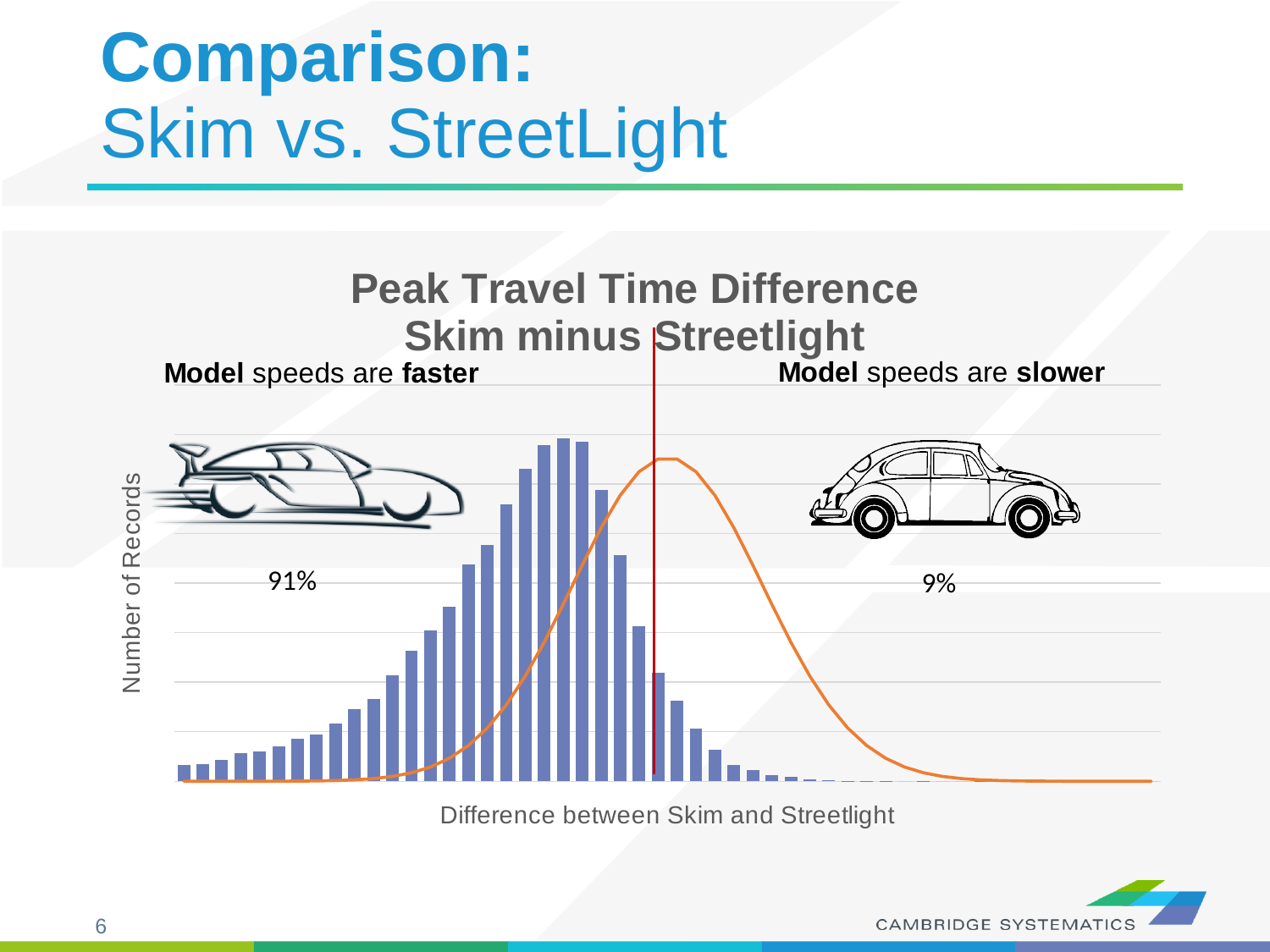
Which side of the chart has the larger share of records: where model speeds are faster or where model speeds are slower? Model speeds are faster What is the label on the vertical axis of the chart? Number of Records What is the difference between the percentage shown on the left side (91%) and the percentage shown on the right side (9%)? 82% What is the title of the chart? Peak Travel Time Difference Skim minus Streetlight What percentage is shown on the right side of the chart, where model speeds are slower? 9% Do the bar heights rise or fall moving from the left edge of the chart toward the tallest bars? Rise What kind of chart is shown on the slide? Bar chart with a line overlay Is the tallest bar located to the left or to the right of the vertical red line? Left What percentage is shown on the left side of the chart, where model speeds are faster? 91% Do the bar heights rise or fall moving from the tallest bars toward the right edge of the chart? Fall